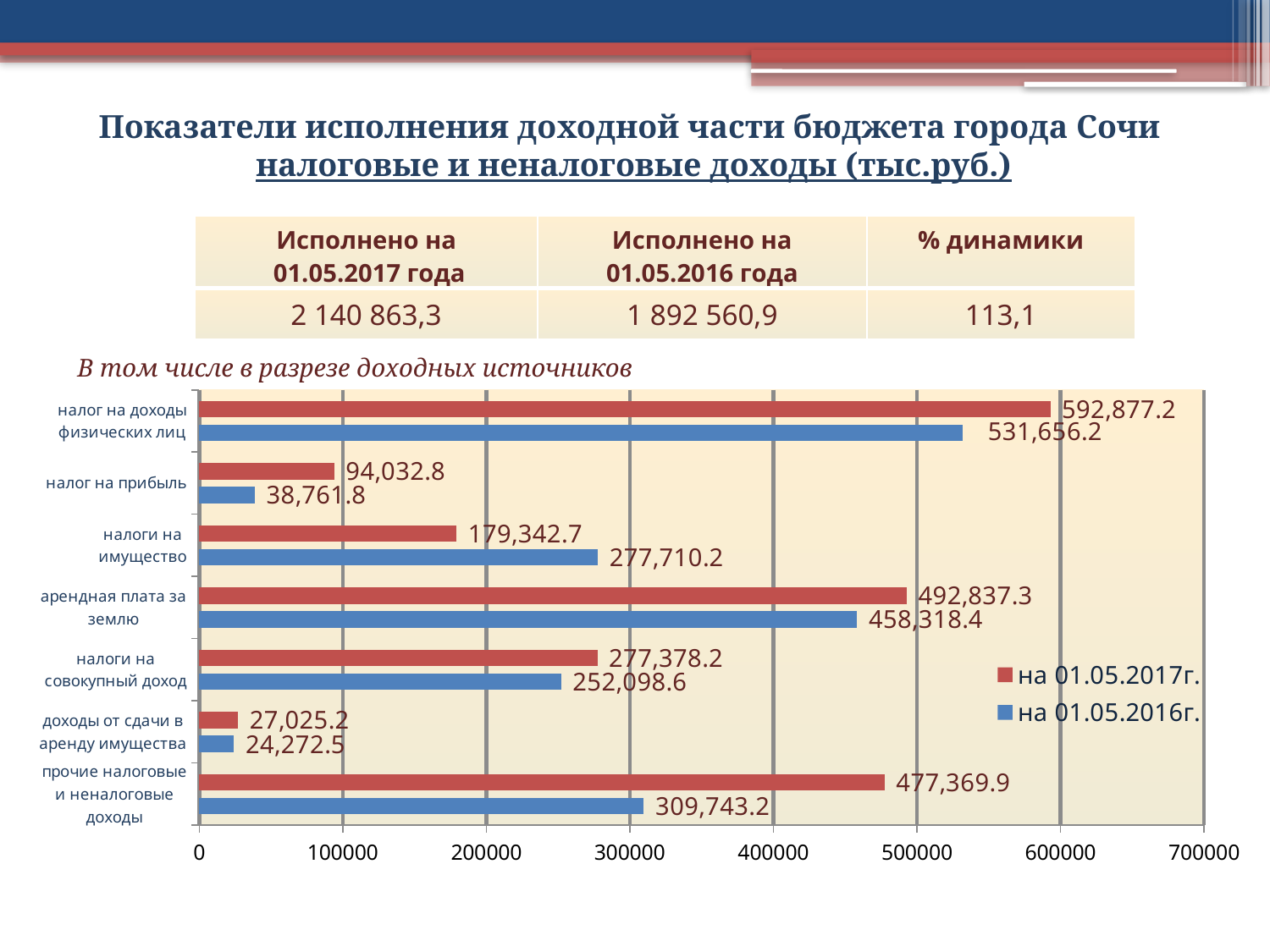
Which category has the highest value in the series на 01.05.2016г.? налог на доходы физических лиц What is the value for налог на доходы физических лиц in the series на 01.05.2017г.? 592,877.2 How many series does the chart legend list? 2 What is the value for налоги на имущество in the series на 01.05.2016г.? 277,710.2 What kind of chart is shown on the slide? bar chart How many categories are shown on the chart? 7 What is the difference between the на 01.05.2016г. and на 01.05.2017г. values for налоги на имущество? 98,367.5 For арендная плата за землю, which series has the larger value: на 01.05.2017г. or на 01.05.2016г.? на 01.05.2017г. Which category has the lowest value in the series на 01.05.2017г.? доходы от сдачи в аренду имущества What is the value for прочие налоговые и неналоговые доходы in the series на 01.05.2017г.? 477,369.9 Is the value for налоги на совокупный доход in the series на 01.05.2016г. greater or less than 300000? less What is the difference between the на 01.05.2017г. and на 01.05.2016г. values for налог на прибыль? 55,271.0